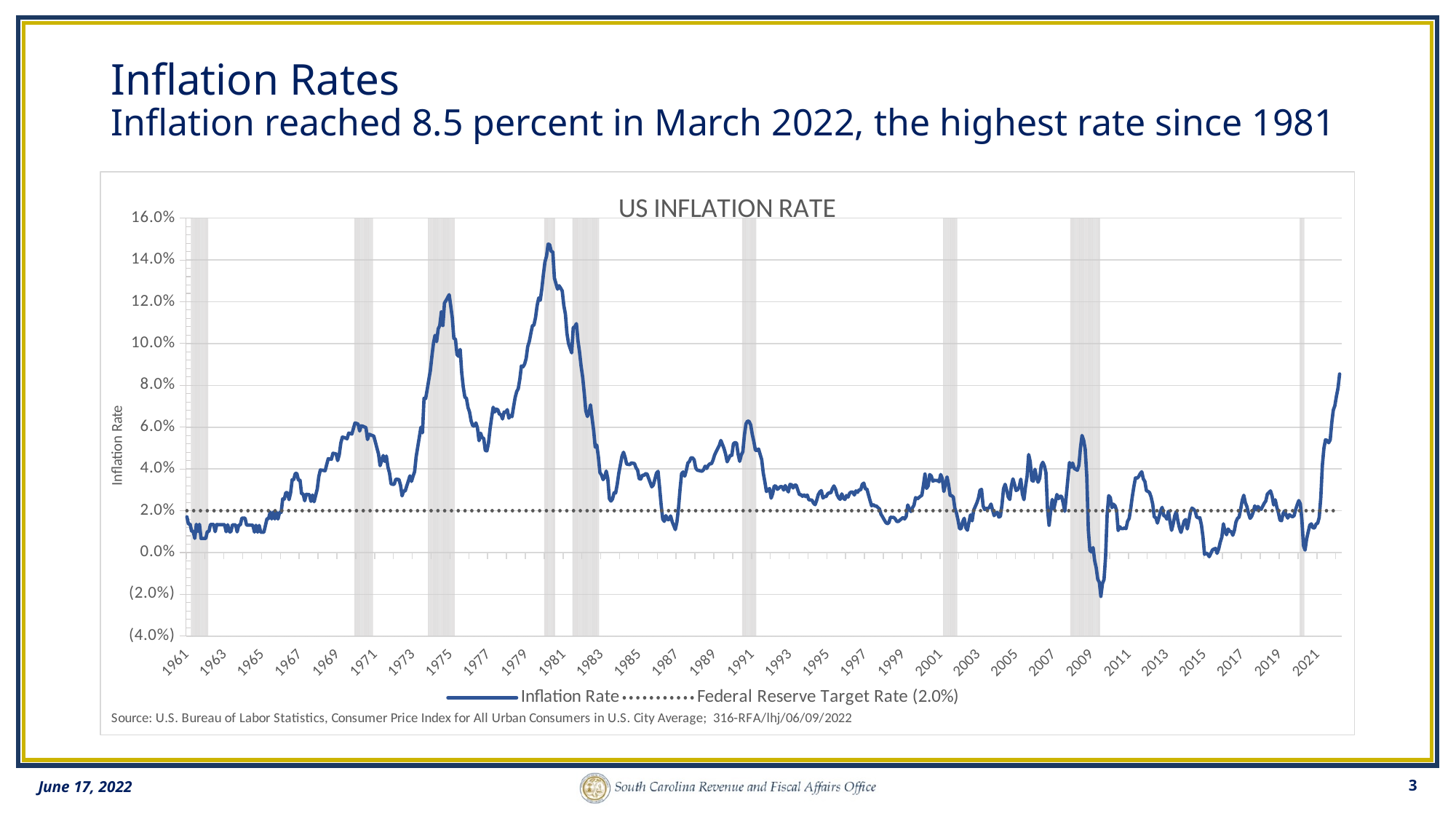
What is the label on the vertical axis of the chart? Inflation Rate Between 1980 and 1983, does the Inflation Rate line rise or fall? fall Is the peak of the Inflation Rate line around 1975 greater or less than 10.0%? greater Is the highest peak of the Inflation Rate line (around 1980) greater or less than 14.0%? greater What is the title of the chart? US INFLATION RATE According to the slide, what inflation rate was reached in March 2022? 8.5 percent Is the lowest point of the Inflation Rate line around 2009 greater or less than 0.0%? less What kind of chart is shown on the slide? line chart Between 2020 and 2022, does the Inflation Rate line rise or fall? rise What value is the Federal Reserve Target Rate shown at in the legend? 2.0% Is the peak of the Inflation Rate line around 1980 higher or lower than the peak around 1975? higher How many series does the chart legend list? 2